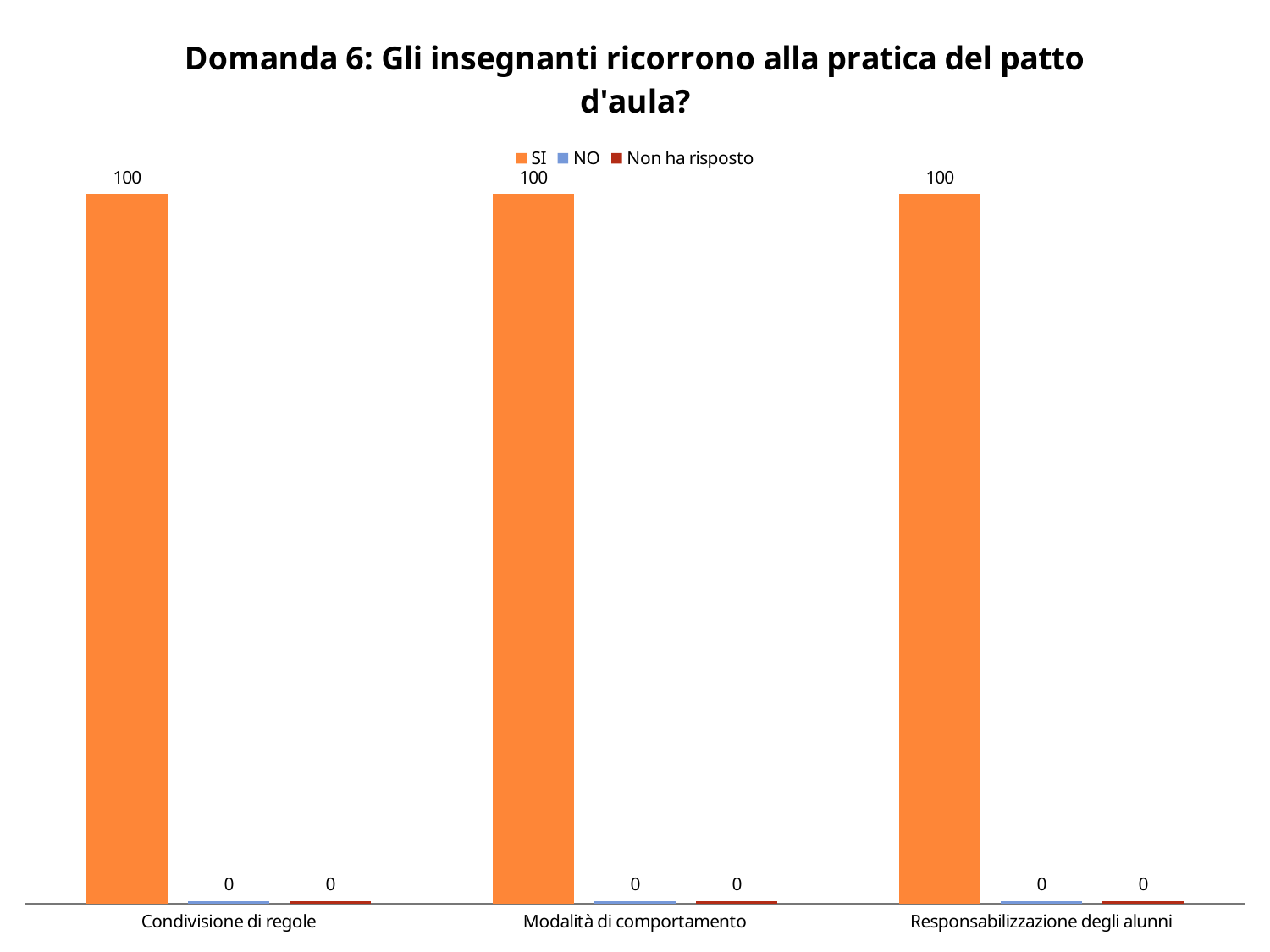
What is the difference between the SI and NO values in the Condivisione di regole category? 100 What is the value for SI in the Responsabilizzazione degli alunni category? 100 Which series has the highest value in the Modalità di comportamento category? SI What kind of chart is shown on the slide? Bar chart What is the value for Non ha risposto in the Responsabilizzazione degli alunni category? 0 How many series does the legend list? 3 Which is larger in the Responsabilizzazione degli alunni category, SI or Non ha risposto? SI Which colour represents the SI series in the legend? Orange What is the value for SI in the Condivisione di regole category? 100 What is the title of the chart? Domanda 6: Gli insegnanti ricorrono alla pratica del patto d'aula? How many categories are shown on the x axis? 3 What is the value for NO in the Modalità di comportamento category? 0